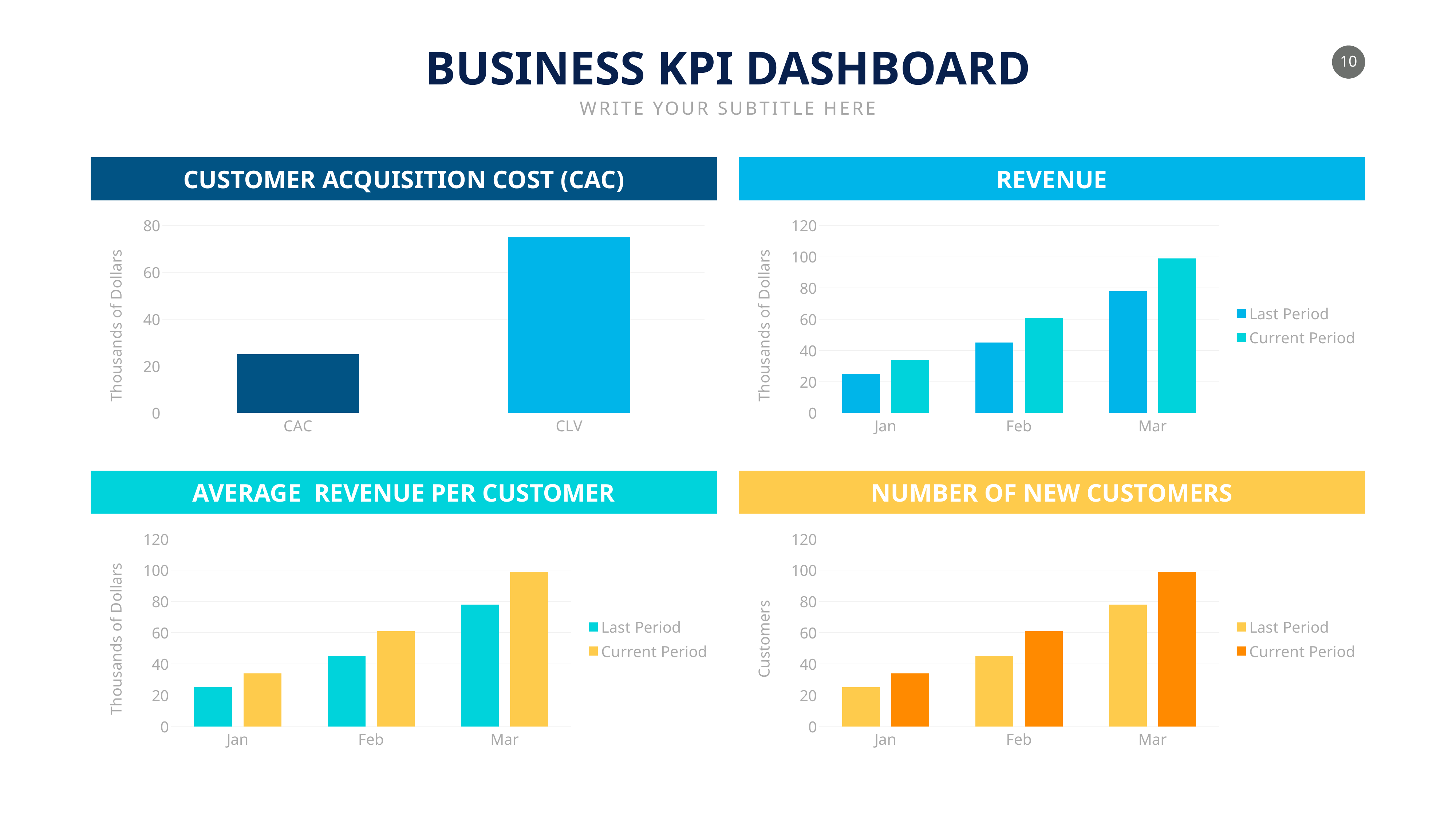
In the Customer Acquisition Cost (CAC) chart, which category has the higher value, CAC or CLV? CLV In the Revenue chart, which month has the highest Current Period value? Mar What is the y-axis label of the Number of New Customers chart? Customers In the Customer Acquisition Cost (CAC) chart, is the value for CLV greater or less than 60? greater How many categories are shown in the Customer Acquisition Cost (CAC) chart? 2 In the Revenue chart, is the Last Period value for Feb greater or less than 40? greater How many series does the legend of the Revenue chart list? 2 In the Customer Acquisition Cost (CAC) chart, is the value for CAC greater or less than 40? less In the Number of New Customers chart, which month has the lowest Last Period value? Jan In the Average Revenue Per Customer chart, do the Last Period values rise or fall from Jan to Mar? rise What kind of chart is the Number of New Customers chart? bar chart